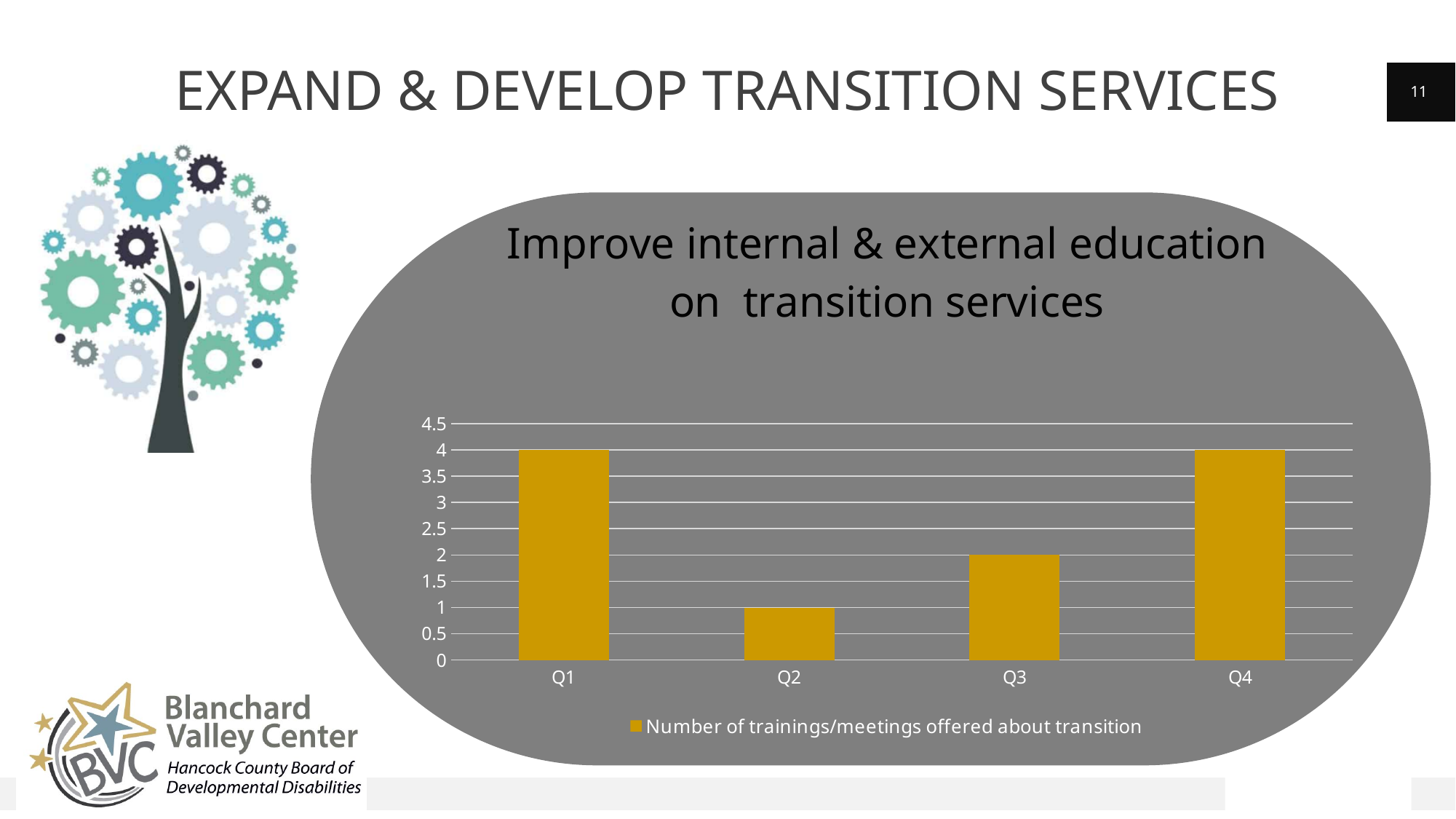
What is the number of trainings/meetings offered about transition in Q1? 4 Which quarter has more trainings/meetings offered about transition, Q2 or Q3? Q3 What is the number of trainings/meetings offered about transition in Q2? 1 Is the value for Q3 greater or less than 3? less What is the number of trainings/meetings offered about transition in Q3? 2 What is the difference between the number of trainings/meetings in Q4 and Q3? 2 What is the difference between the number of trainings/meetings in Q1 and Q2? 3 What kind of chart is shown on the slide? Bar chart How many series does the chart legend list? 1 How many quarters are shown on the x axis of the chart? 4 What is the number of trainings/meetings offered about transition in Q4? 4 Which quarter has the lowest number of trainings/meetings offered about transition? Q2